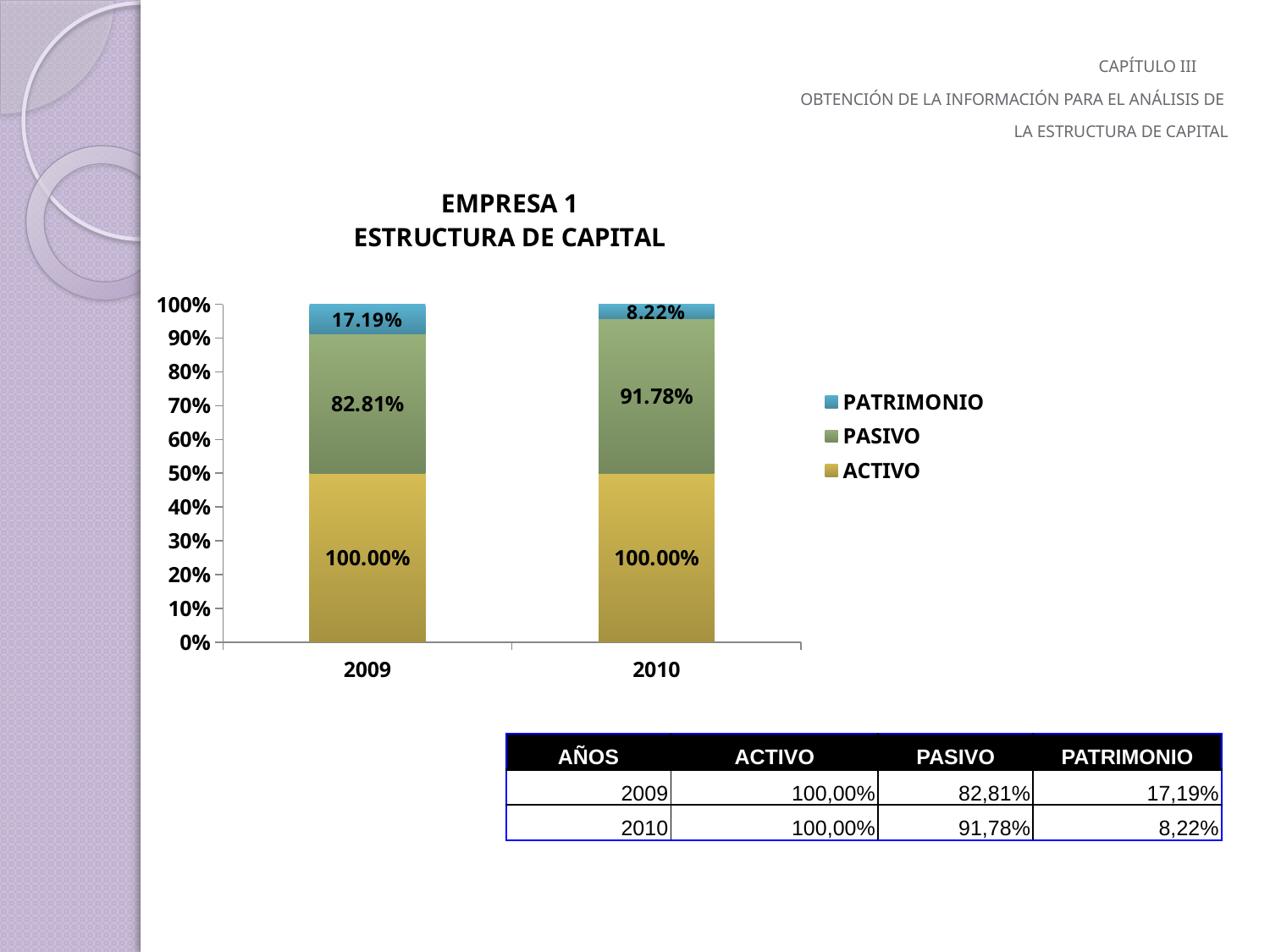
What is the difference between the PASIVO values for 2010 and 2009? 8.97% In which year is the PATRIMONIO value lowest? 2010 How many years are shown on the x axis? 2 How many series does the legend list? 3 Does the PASIVO value rise or fall from 2009 to 2010? Rise What is the PATRIMONIO value for 2009? 17.19% Which is larger, the PATRIMONIO value for 2009 or for 2010? 2009 What kind of chart is shown? Stacked bar chart What is the PATRIMONIO value for 2010? 8.22% What is the ACTIVO value for 2010? 100.00% What is the PASIVO value for 2009? 82.81% In which year is the PASIVO value highest? 2010